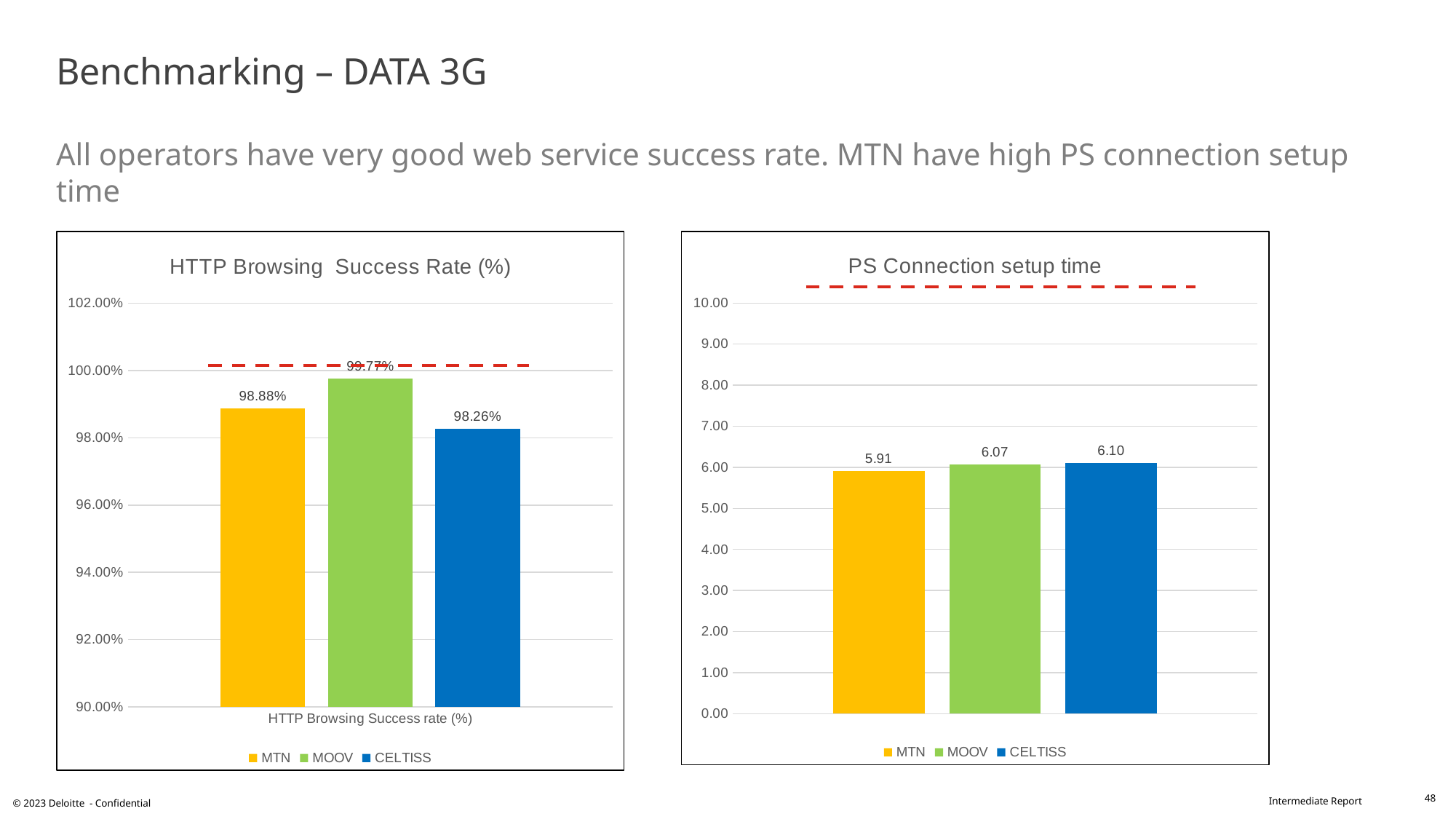
In the HTTP Browsing Success Rate (%) chart, which operator has the highest success rate? MOOV In the PS Connection setup time chart, is the value for CELTISS greater or less than 7.00? less What kind of chart is the HTTP Browsing Success Rate (%) chart? Bar chart In the HTTP Browsing Success Rate (%) chart, what is the value for MTN? 98.88% In the PS Connection setup time chart, what is the value for MOOV? 6.07 In the PS Connection setup time chart, what is the value for MTN? 5.91 How many series does the legend of the PS Connection setup time chart list? 3 In the HTTP Browsing Success Rate (%) chart, which operator has the lowest success rate? CELTISS In the HTTP Browsing Success Rate (%) chart, what is the value for CELTISS? 98.26% In the PS Connection setup time chart, what is the difference between the CELTISS and MTN values? 0.19 In the HTTP Browsing Success Rate (%) chart, what is the difference between the MTN and CELTISS values? 0.62% In the PS Connection setup time chart, which operator has the lowest setup time? MTN